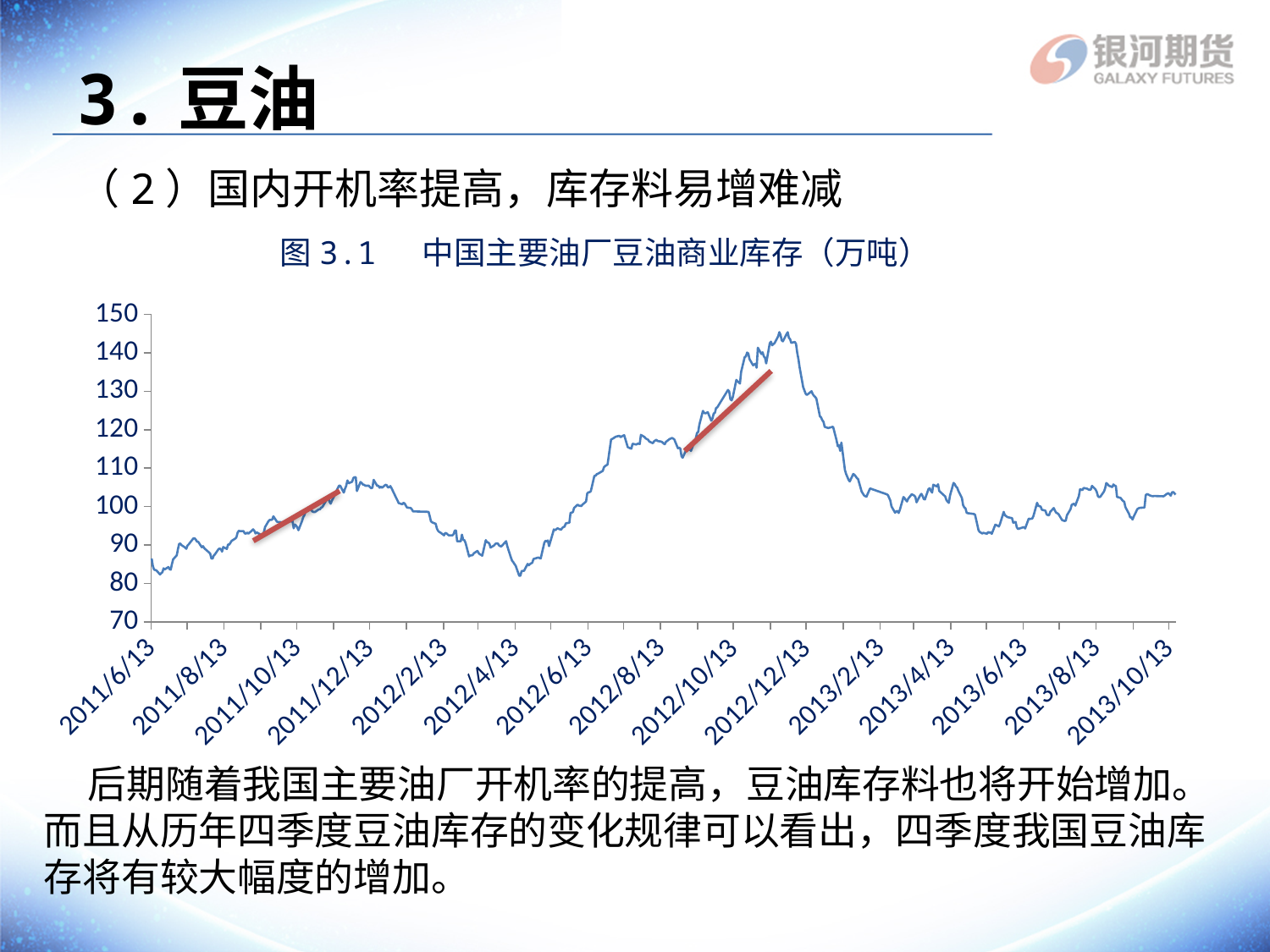
How many red trend-line segments are drawn on the chart? 2 How many date labels are shown on the x axis? 15 Does the line rise or fall between 2012/8/13 and 2012/12/13? rise Is the highest point of the line greater or less than 140? greater What is the title of the chart? 图 3.1 中国主要油厂豆油商业库存（万吨） Is the value at 2011/12/13 greater or less than 100? greater Is the value at 2013/10/13 greater or less than 100? greater Does the line rise or fall between 2012/12/13 and 2013/2/13? fall What kind of chart is shown on the slide? line chart